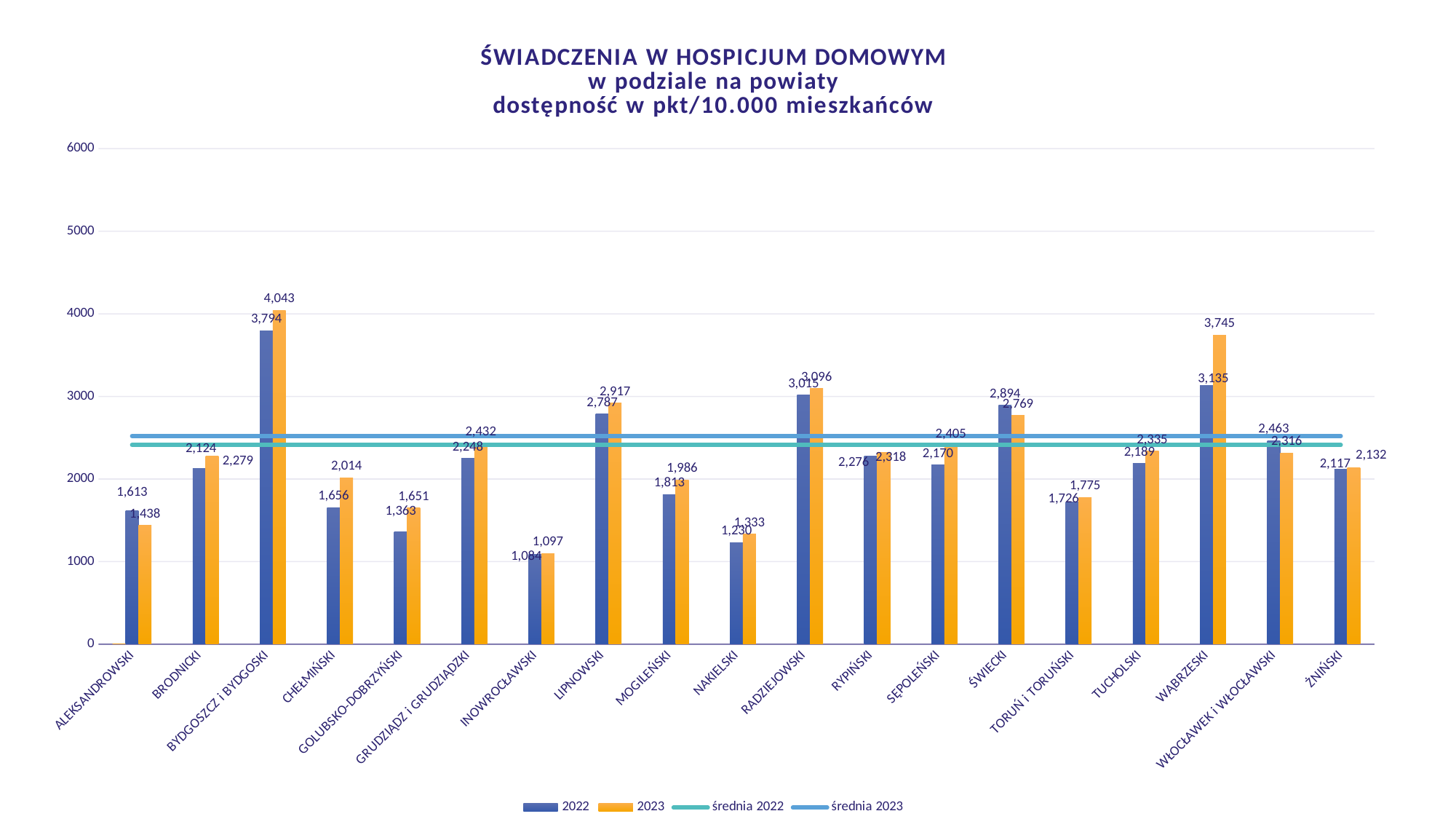
What is the 2023 value for BYDGOSZCZ i BYDGOSKI? 4,043 What is the 2023 value for SĘPOLEŃSKI? 2,405 Which powiat has the highest 2023 value? BYDGOSZCZ i BYDGOSKI How many powiaty (categories) are shown on the x axis? 19 Is the 2023 value for RADZIEJOWSKI greater or less than 3000? greater How many series does the legend list? 4 For ŚWIECKI, which is larger: the 2022 value or the 2023 value? 2022 What is the difference between the 2023 and 2022 values for WĄBRZESKI? 610 What kind of chart is this? combination bar and line chart What is the 2022 value for WĄBRZESKI? 3,135 Which legend entry is shown in orange? 2023 Which powiat has the lowest 2022 value? INOWROCŁAWSKI